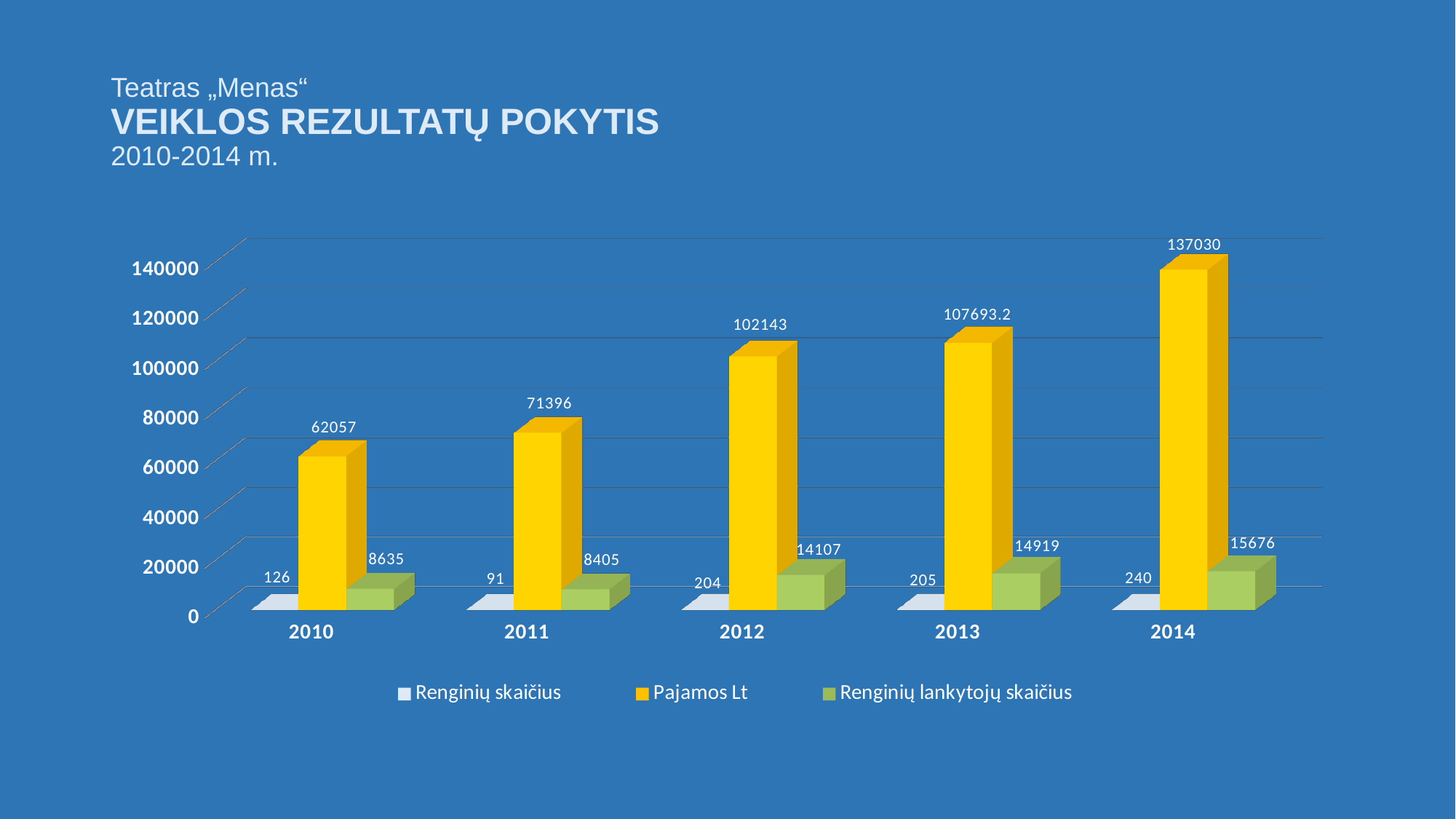
What is the value of Pajamos Lt for 2013? 107693.2 What is the value of Renginių lankytojų skaičius for 2012? 14107 Which year has the lowest Renginių skaičius? 2011 What is the difference in Pajamos Lt between 2011 and 2010? 9339 Which year has the highest Pajamos Lt? 2014 How many years are shown on the x axis? 5 Which is larger: Renginių lankytojų skaičius in 2010 or in 2011? 2010 Is the value of Pajamos Lt for 2012 greater or less than 100000? greater What is the value of Renginių skaičius for 2011? 91 How many series does the legend list? 3 What is the value of Pajamos Lt for 2014? 137030 Does Pajamos Lt rise or fall from 2010 to 2014? rise